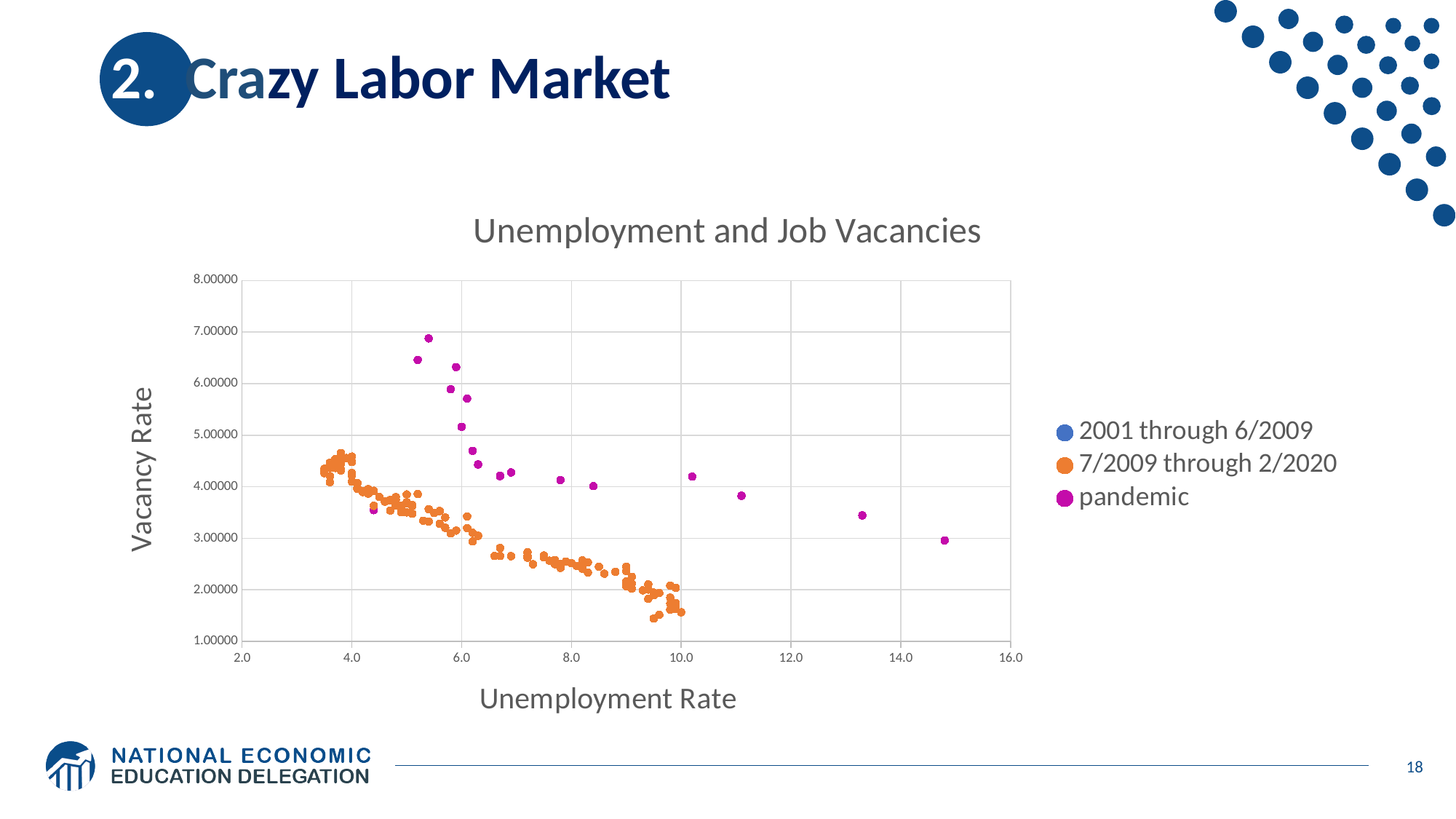
What kind of chart is shown on the slide? scatter chart Is the highest vacancy rate reached by the pandemic series greater or less than 6.00000? greater Is the vacancy rate of the 7/2009 through 2/2020 points near 10.0 unemployment greater or less than 2.00000? less For the 7/2009 through 2/2020 series, does the vacancy rate rise or fall as the unemployment rate increases? fall Which series contains the point with the highest vacancy rate, 7/2009 through 2/2020 or pandemic? pandemic Which series contains the point with the highest unemployment rate, 7/2009 through 2/2020 or pandemic? pandemic What is the label of the horizontal axis of the chart? Unemployment Rate What is the title of the chart? Unemployment and Job Vacancies How many series does the chart's legend list? 3 Is the highest vacancy rate reached by the 7/2009 through 2/2020 series greater or less than 5.00000? less What is the maximum value shown on the horizontal axis of the chart? 16.0